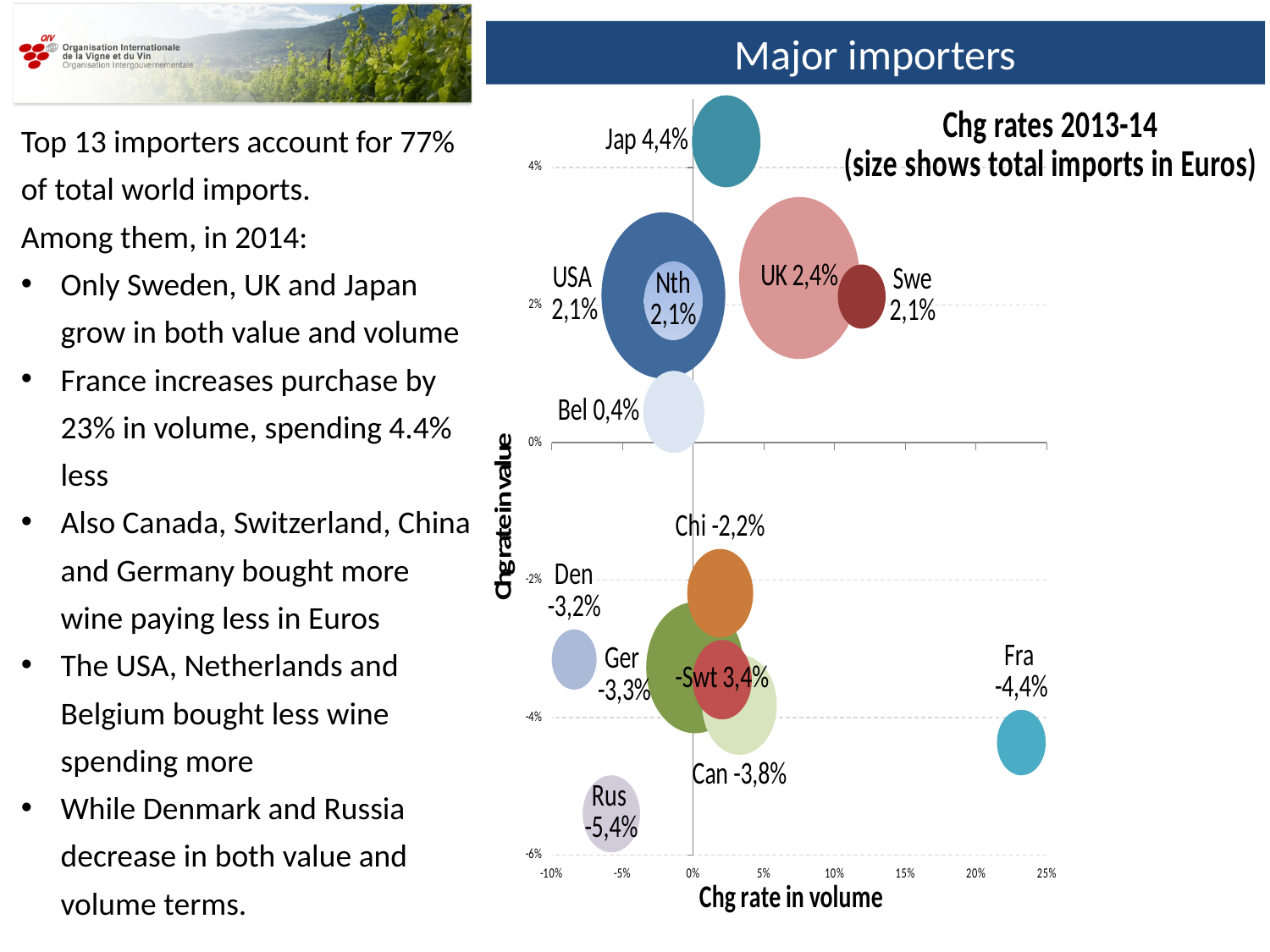
What is the change rate in value labelled for France (Fra)? -4,4% Is the change rate in volume for France (Fra) greater or less than 20%? greater What is the difference between the labelled change rates in value for Japan (4,4%) and the UK (2,4%)? 2,0 percentage points What is the change rate in value labelled for Russia (Rus)? -5,4% Which has the larger labelled change rate in value, the UK or Sweden (Swe)? UK Which importer has the highest labelled change rate in value? Jap What is the change rate in value labelled for Japan (Jap)? 4,4% Which importer has the lowest labelled change rate in value? Rus What kind of chart is shown on the slide? bubble chart What is the label of the x axis of the chart? Chg rate in volume What is the change rate in value labelled for the UK? 2,4% How many importers are plotted as bubbles on the chart? 13